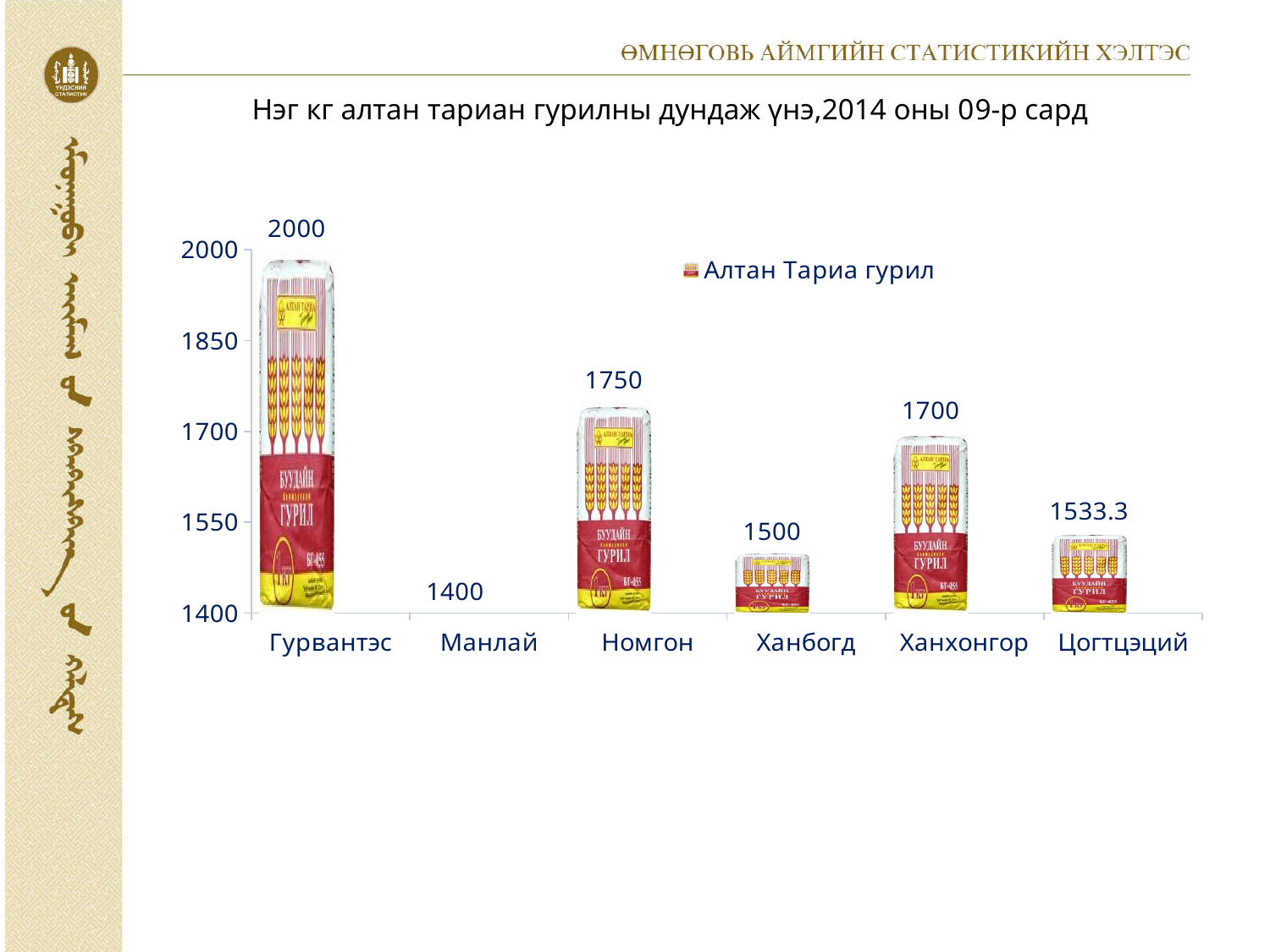
What kind of chart is shown on the slide? bar chart What is the value for Ханхонгор? 1700 How many series does the legend list? 1 Is the value for Цогтцэций greater or less than 1550? less What is the difference between the values for Ханхонгор and Ханбогд? 200 What is the value for Гурвантэс? 2000 How many categories are shown on the x axis? 6 Which category has the lowest value? Манлай Which is larger, the value for Номгон or the value for Ханхонгор? Номгон Which category has the highest value? Гурвантэс What is the difference between the values for Гурвантэс and Номгон? 250 What is the value for Цогтцэций? 1533.3